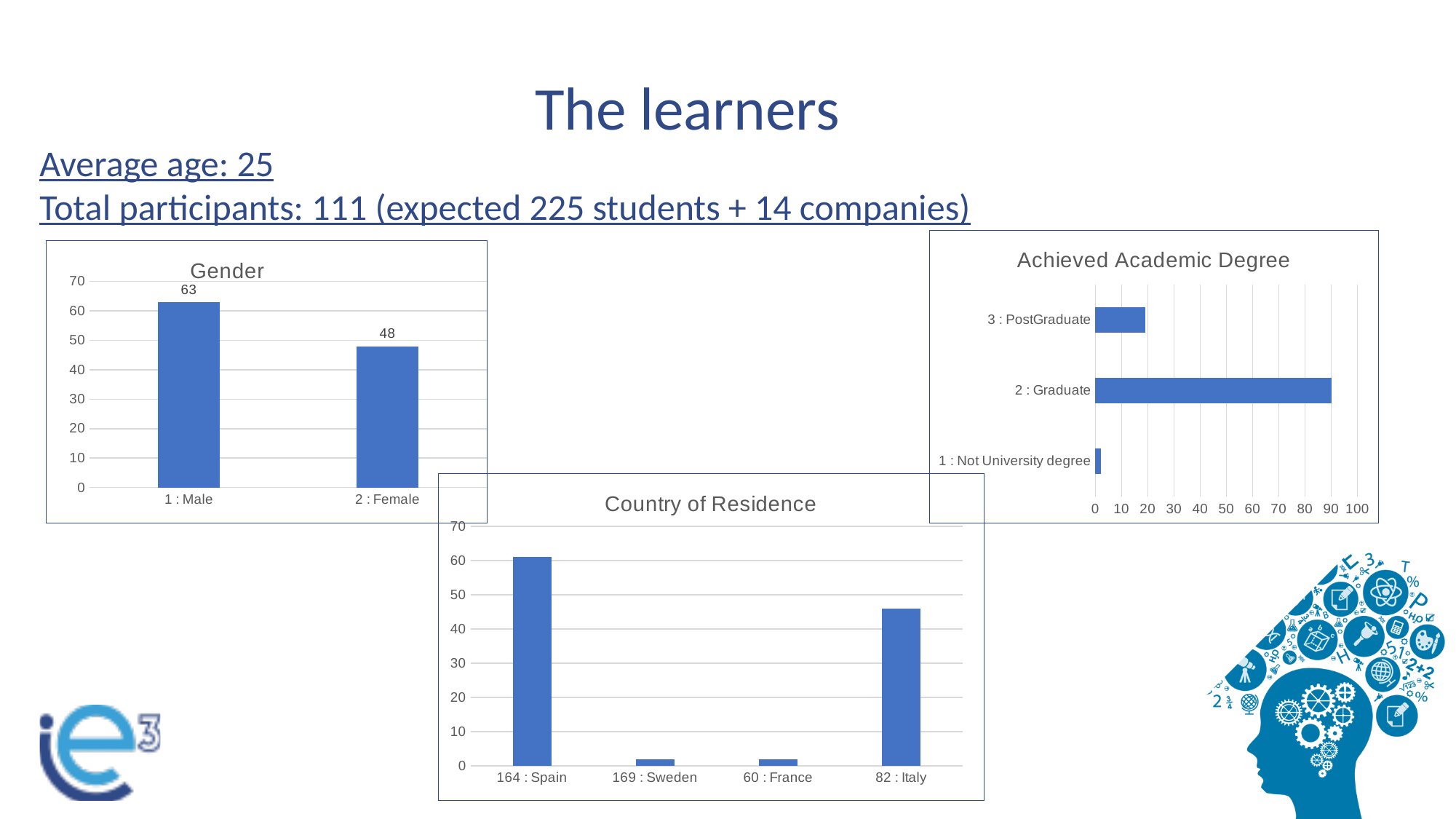
In the Achieved Academic Degree chart, which category has the highest value? 2 : Graduate In the Achieved Academic Degree chart, is the value for 2 : Graduate greater or less than 80? greater In the Gender chart, what is the total of the two bars? 111 In the Country of Residence chart, which country has the highest value? 164 : Spain In the Gender chart, which category has the higher value? 1 : Male In the Gender chart, what is the value for 2 : Female? 48 In the Country of Residence chart, is the value for 82 : Italy greater or less than 40? greater In the Gender chart, what is the difference between the Male and Female values? 15 In the Gender chart, what is the value for 1 : Male? 63 In the Achieved Academic Degree chart, is the value for 3 : PostGraduate greater or less than 30? less How many categories are shown in the Country of Residence chart? 4 In the Achieved Academic Degree chart, which category has the lowest value? 1 : Not University degree